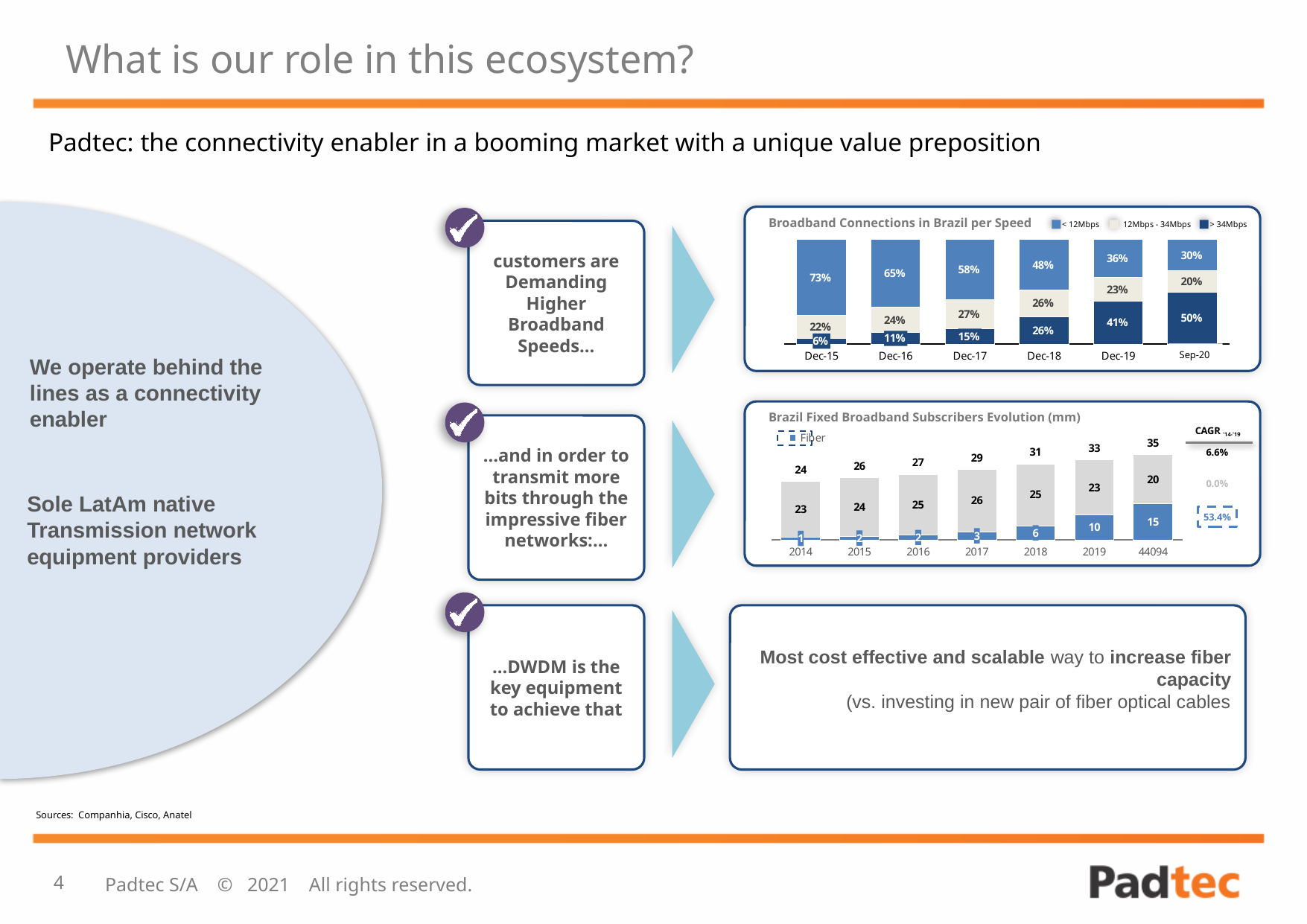
In the 'Broadband Connections in Brazil per Speed' chart, does the share of < 12Mbps connections rise or fall from Dec-15 to Sep-20? Fall What type of chart is 'Brazil Fixed Broadband Subscribers Evolution (mm)'? Stacked bar chart In the 'Broadband Connections in Brazil per Speed' chart, what share of connections was > 34Mbps in Sep-20? 50% In the 'Broadband Connections in Brazil per Speed' chart, what share of connections was < 12Mbps in Dec-15? 73% In the 'Broadband Connections in Brazil per Speed' chart, which period has the lowest share of > 34Mbps connections? Dec-15 In the 'Brazil Fixed Broadband Subscribers Evolution (mm)' chart, what is the fiber value for 2019? 10 In the 'Brazil Fixed Broadband Subscribers Evolution (mm)' chart, what is the CAGR '14-'19 shown for fiber? 53.4% In the 'Brazil Fixed Broadband Subscribers Evolution (mm)' chart, what is the total number of subscribers shown for 2017? 29 In the 'Broadband Connections in Brazil per Speed' chart, what is the difference between the > 34Mbps share in Dec-19 and in Dec-18? 15% In the 'Broadband Connections in Brazil per Speed' chart, how many series does the legend list? 3 In the 'Brazil Fixed Broadband Subscribers Evolution (mm)' chart, which year has the highest fiber value? 44094 In the 'Brazil Fixed Broadband Subscribers Evolution (mm)' chart, how many years are shown on the x axis? 7